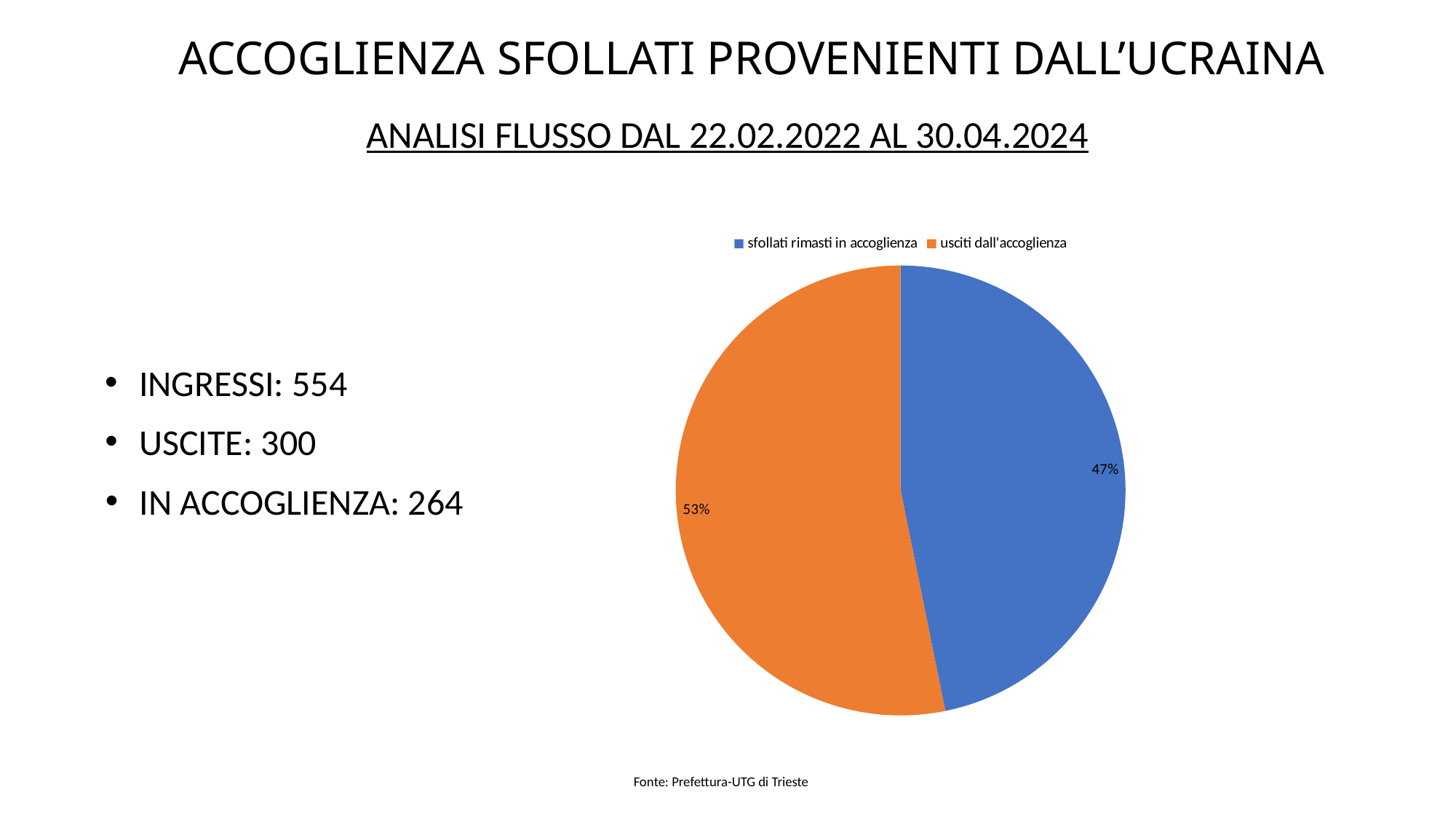
What kind of chart is shown on the slide? pie chart Which slice of the pie is the largest? usciti dall'accoglienza What colour is the 'usciti dall'accoglienza' slice? orange What share of the pie does 'sfollati rimasti in accoglienza' represent? 47% Which slice of the pie is the smallest? sfollati rimasti in accoglienza What is the difference in percentage points between the 'usciti dall'accoglienza' slice and the 'sfollati rimasti in accoglienza' slice? 6% Is the share for 'sfollati rimasti in accoglienza' greater or less than 50%? less What share of the pie does 'usciti dall'accoglienza' represent? 53% How many slices does the pie chart have? 2 How many entries does the chart legend list? 2 What source is cited below the chart? Fonte: Prefettura-UTG di Trieste Which is larger: the share for 'sfollati rimasti in accoglienza' or the share for 'usciti dall'accoglienza'? usciti dall'accoglienza